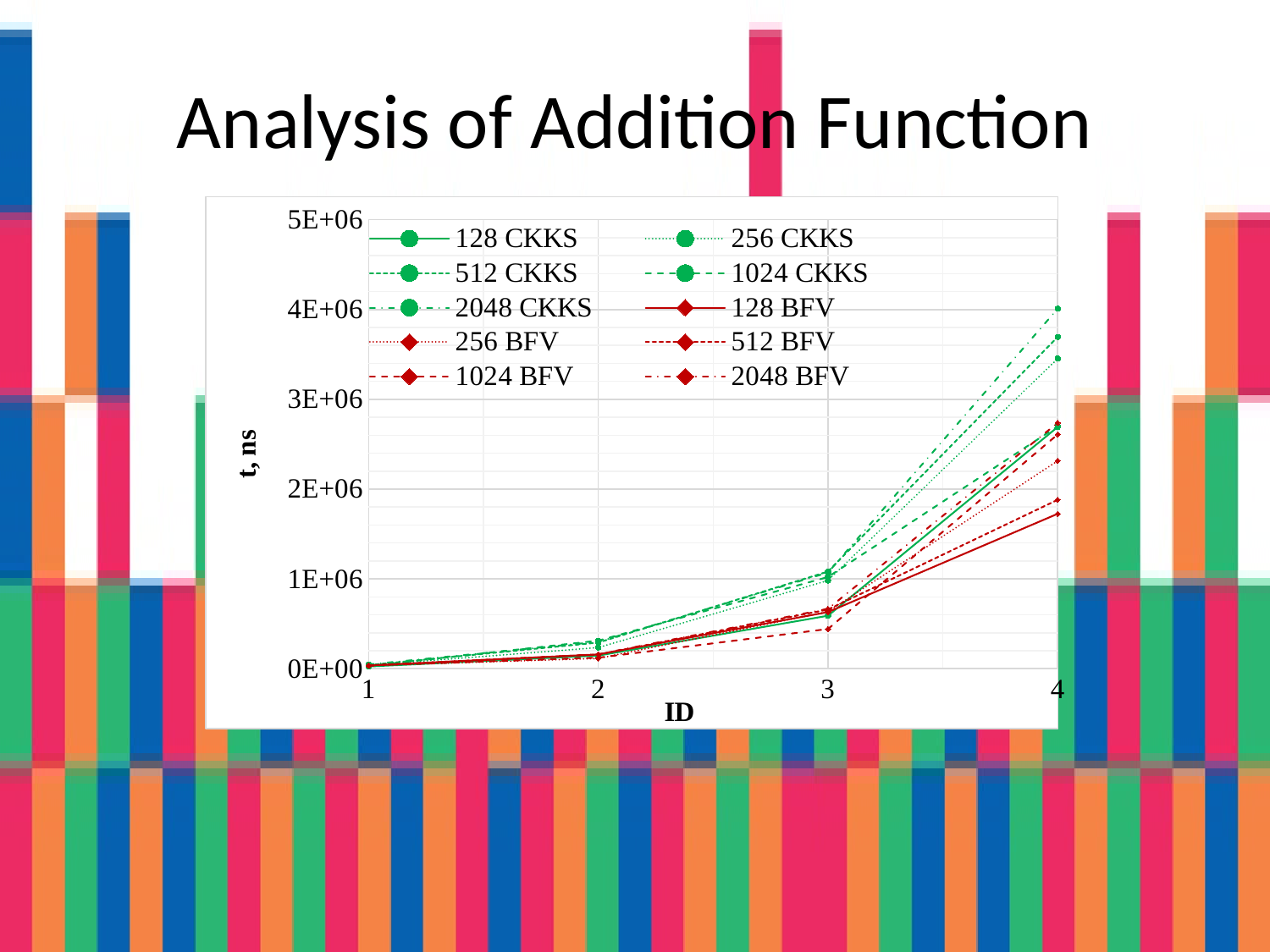
How many series does the legend list? 10 Is the value for 128 CKKS at ID 4 greater or less than 2E+06? greater What kind of chart is shown on the slide? line chart How many ID values are plotted along the x axis? 4 Do the values rise or fall as ID increases from 1 to 4? rise What is the title of the slide? Analysis of Addition Function Is the value for 128 BFV at ID 3 greater or less than 1E+06? less Which series has the lowest value at ID 4? 128 BFV At ID 4, which is larger: 128 CKKS or 128 BFV? 128 CKKS What is the label of the y axis? t, ns Is the value for 128 BFV at ID 4 greater or less than 2E+06? less